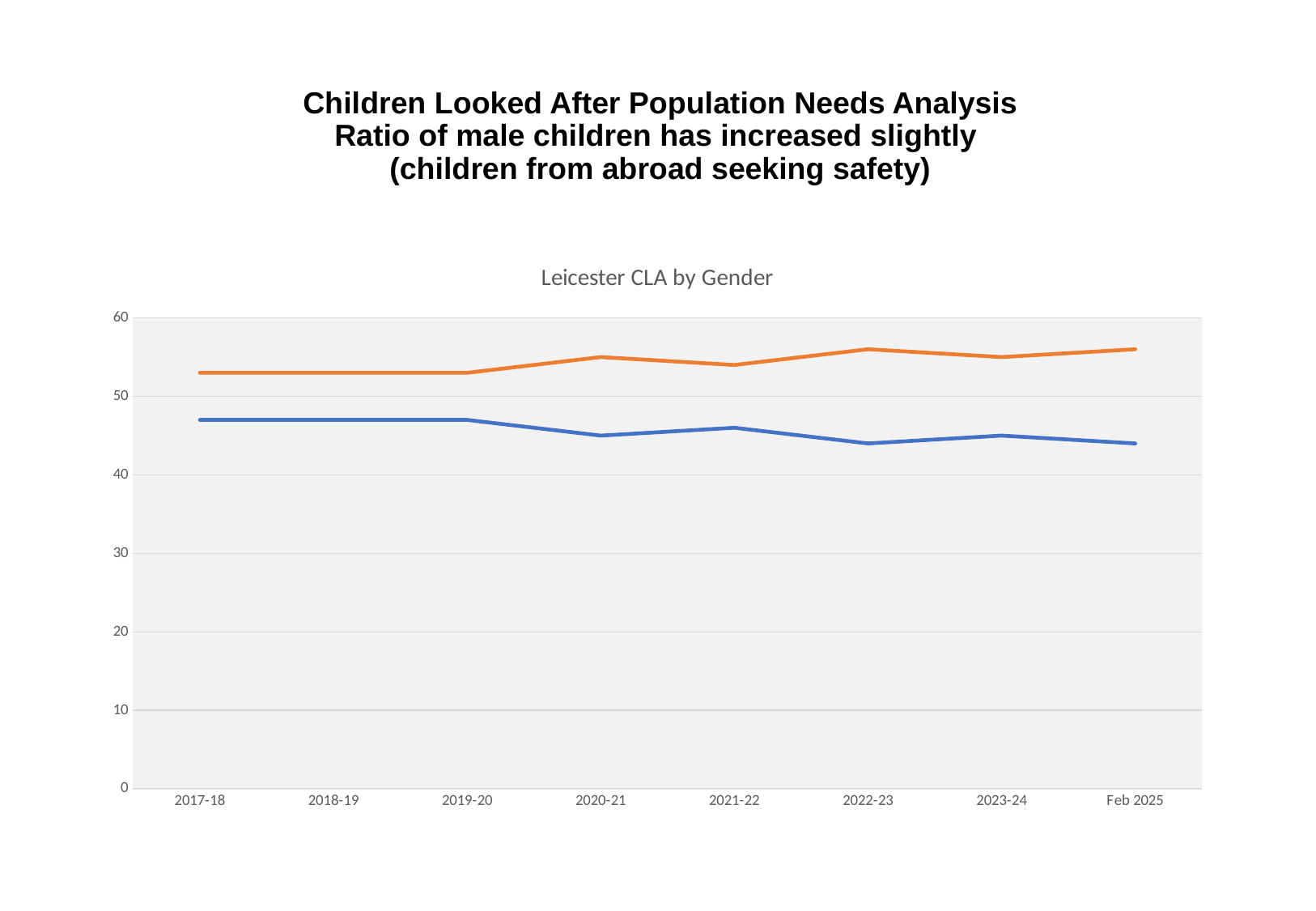
Which line has the higher value in 2022-23, the orange line or the blue line? the orange line Does the blue line generally rise or fall from 2017-18 to Feb 2025? fall Does the orange line generally rise or fall from 2017-18 to Feb 2025? rise What is the title of the chart? Leicester CLA by Gender Is the value of the blue line for Feb 2025 greater or less than 40? greater What is the first time period shown on the x axis? 2017-18 How many time periods are shown along the x axis of the chart? 8 How many lines are plotted on the chart? 2 Is the value of the blue line for 2017-18 greater or less than 50? less Is the value of the orange line for Feb 2025 greater or less than 60? less What kind of chart is shown on the slide? line chart